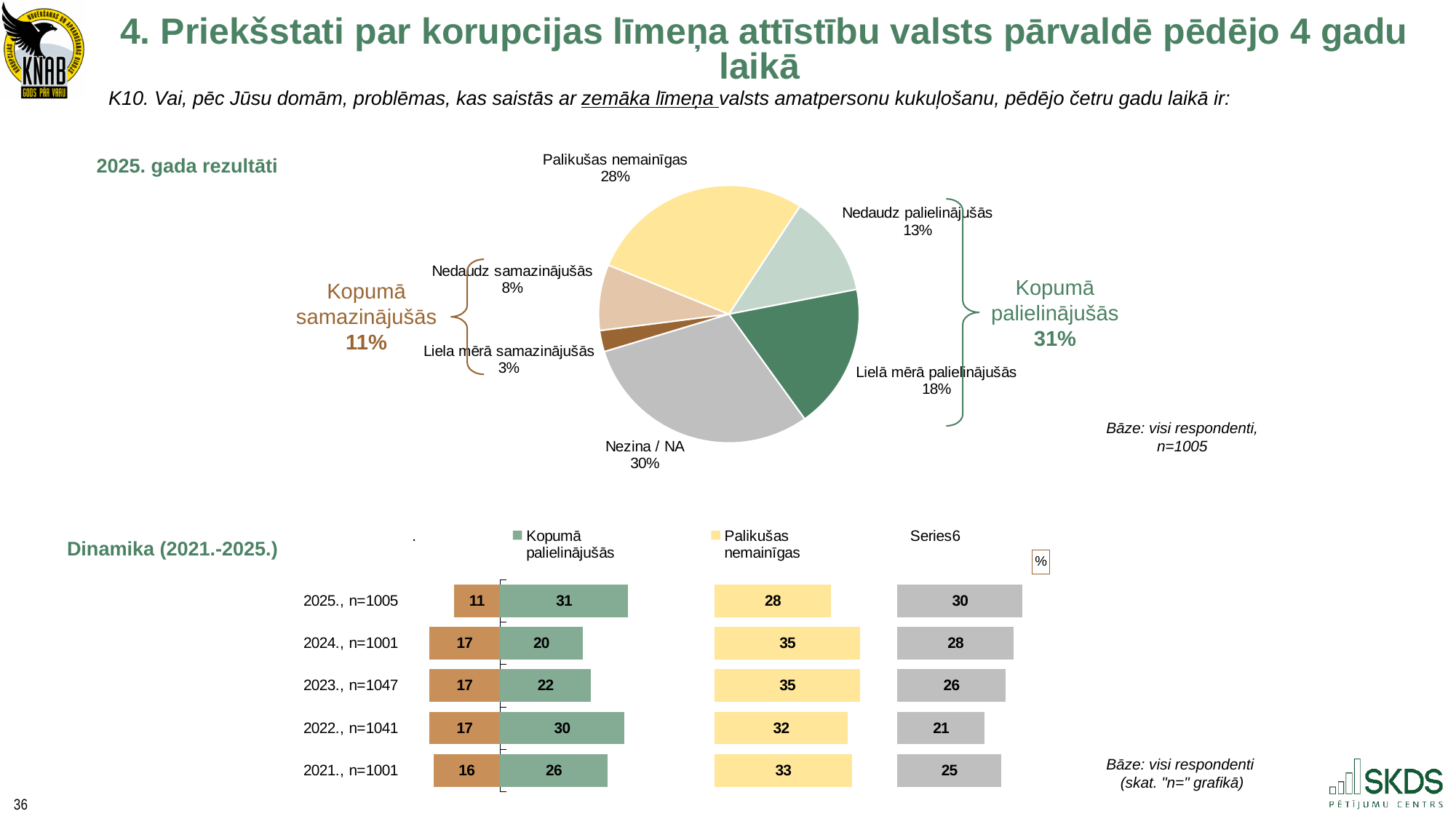
In the pie chart (2025. gada rezultāti), how many slices does the pie have? 6 In the bar chart (Dinamika 2021.-2025.), what is the value of "Palikušas nemainīgas" for 2022., n=1041? 32 In the pie chart (2025. gada rezultāti), which category has the smallest slice? Liela mērā samazinājušās In the pie chart (2025. gada rezultāti), which category has the largest slice? Nezina / NA What kind of chart is the lower chart (Dinamika 2021.-2025.)? bar chart In the pie chart (2025. gada rezultāti), what percentage of respondents answered "Nezina / NA"? 30% In the bar chart (Dinamika 2021.-2025.), which year has the highest value for "Kopumā palielinājušās"? 2025., n=1005 In the pie chart (2025. gada rezultāti), what is the difference between "Palikušas nemainīgas" and "Nedaudz palielinājušās"? 15% In the pie chart (2025. gada rezultāti), what share is shown for "Lielā mērā palielinājušās"? 18% In the bar chart (Dinamika 2021.-2025.), what is the value of "Kopumā palielinājušās" for 2024., n=1001? 20 In the bar chart (Dinamika 2021.-2025.), is the "Palikušas nemainīgas" value larger in 2023., n=1047 or in 2025., n=1005? 2023., n=1047 In the pie chart (2025. gada rezultāti), what combined percentage is shown for "Kopumā palielinājušās"? 31%